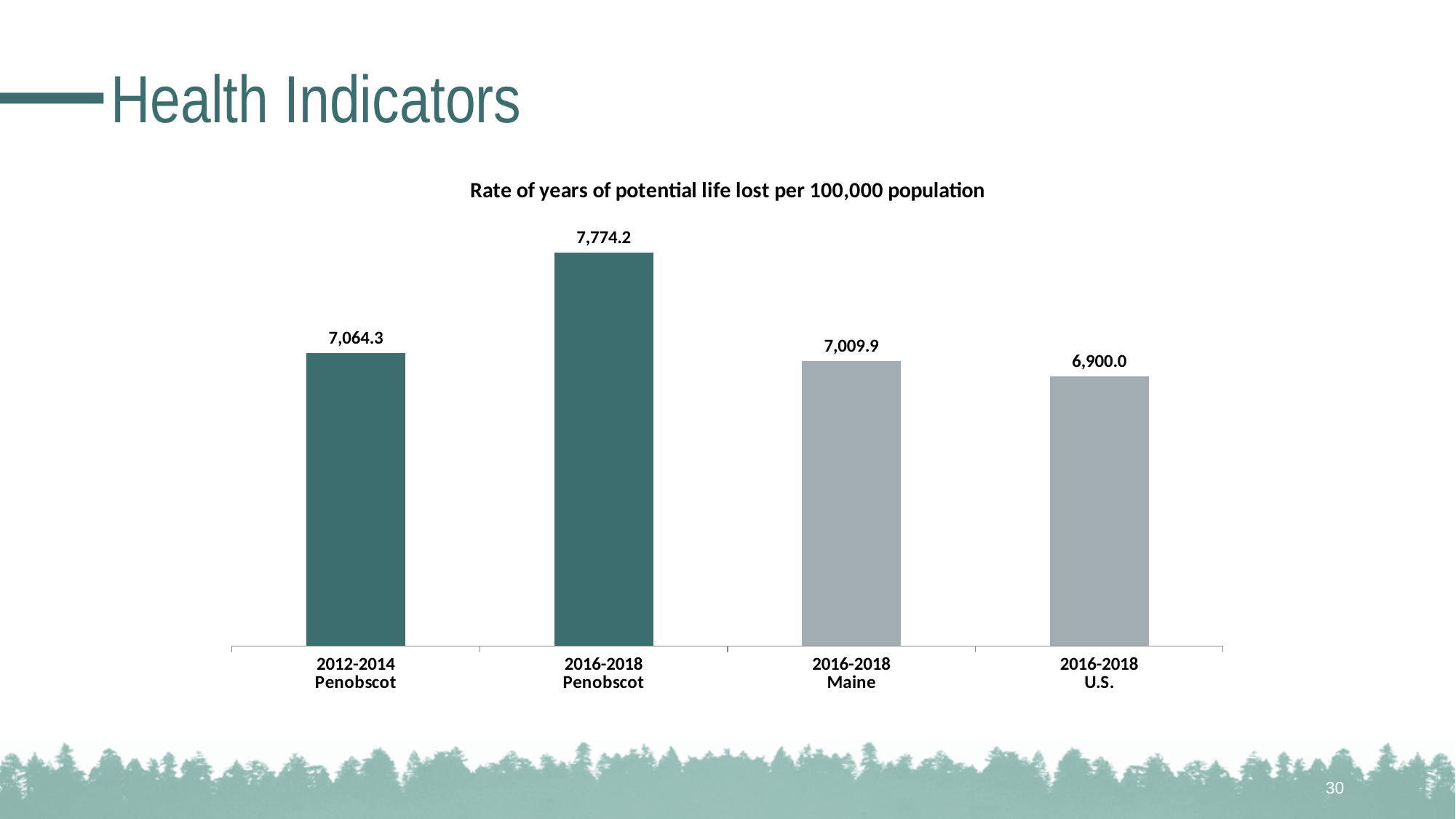
What is the title of the chart? Rate of years of potential life lost per 100,000 population What is the value shown for 2012-2014 Penobscot? 7,064.3 What type of chart is shown on the slide? Bar chart Which category has the highest rate of years of potential life lost? 2016-2018 Penobscot How many bars are shown in the chart? 4 What is the value shown for 2016-2018 Maine? 7,009.9 What is the difference between the 2016-2018 Penobscot value and the 2016-2018 U.S. value? 874.2 What is the value shown for 2016-2018 U.S.? 6,900.0 Which category has the lowest rate of years of potential life lost? 2016-2018 U.S. What is the rate of years of potential life lost per 100,000 population for 2016-2018 Penobscot? 7,774.2 What is the difference between the 2016-2018 Penobscot value and the 2012-2014 Penobscot value? 709.9 Which is larger, the 2016-2018 Maine value or the 2016-2018 U.S. value? 2016-2018 Maine